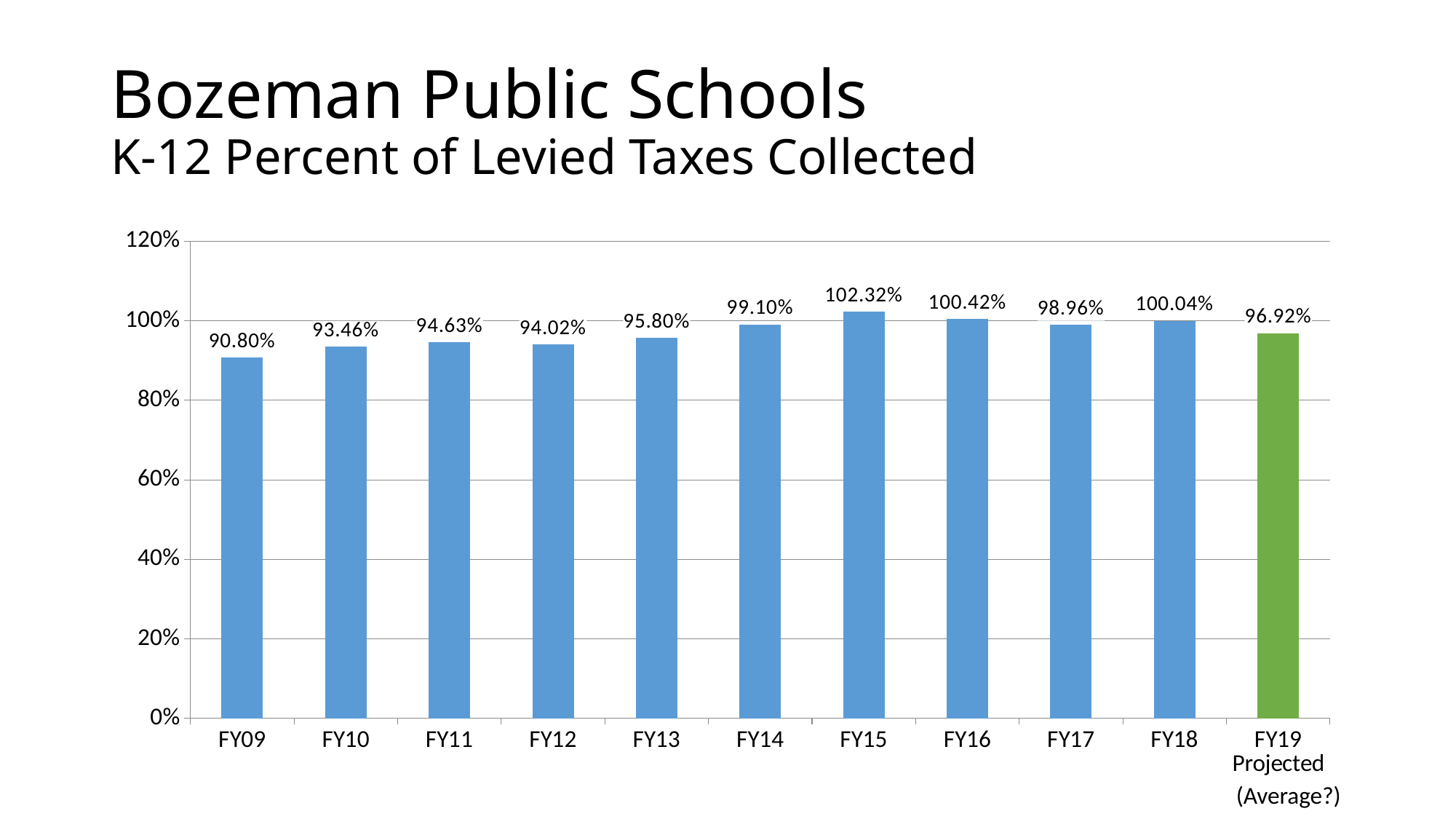
How many fiscal years are shown on the x axis? 11 What is the projected percent of levied taxes collected for FY19? 96.92% Is the value for FY14 greater or less than 100%? less Which bar is coloured green instead of blue? FY19 Projected What kind of chart is shown on the slide? bar chart Which fiscal year has the lowest percent of levied taxes collected? FY09 What is the value shown for FY12? 94.02% Do the values generally rise or fall from FY09 to FY15? rise Which fiscal year has the highest percent of levied taxes collected? FY15 Which is larger, the value for FY16 or the value for FY18? FY16 What is the percent of levied taxes collected for FY15? 102.32% What is the difference between the FY15 value and the FY09 value? 11.52%